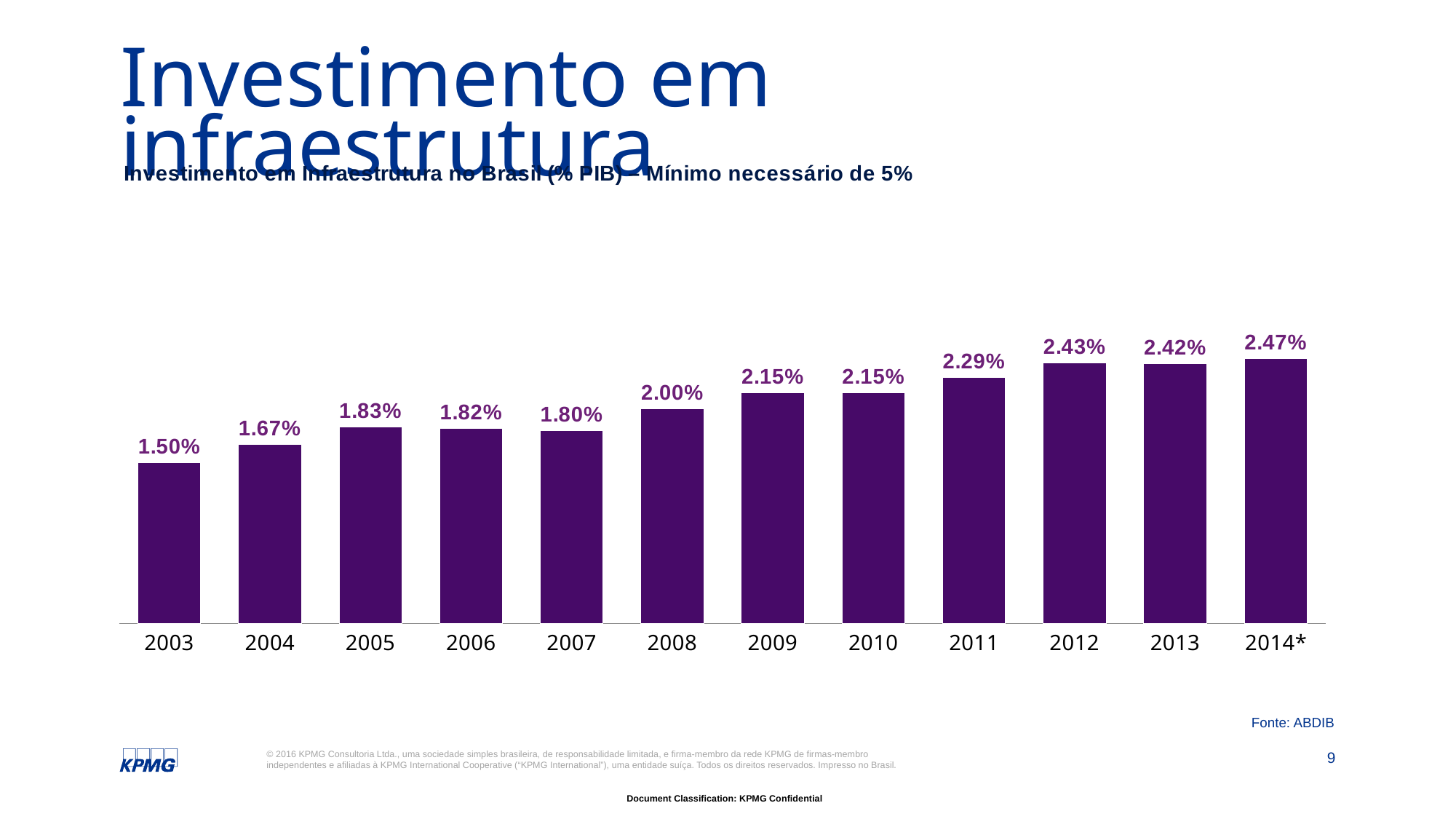
What is the value for 2014*? 2.47% Do the values generally rise or fall from 2003 to 2014*? Rise How many years are shown on the x axis? 12 What is the value for 2011? 2.29% What is the difference between the values for 2014* and 2003? 0.97% What is the value for 2003? 1.50% Which year has the lowest value? 2003 What kind of chart is shown on the slide? Bar chart Which is larger, the value for 2008 or the value for 2005? 2008 Which year has the highest value? 2014* What is the value for 2008? 2.00% What is the difference between the values for 2012 and 2011? 0.14%